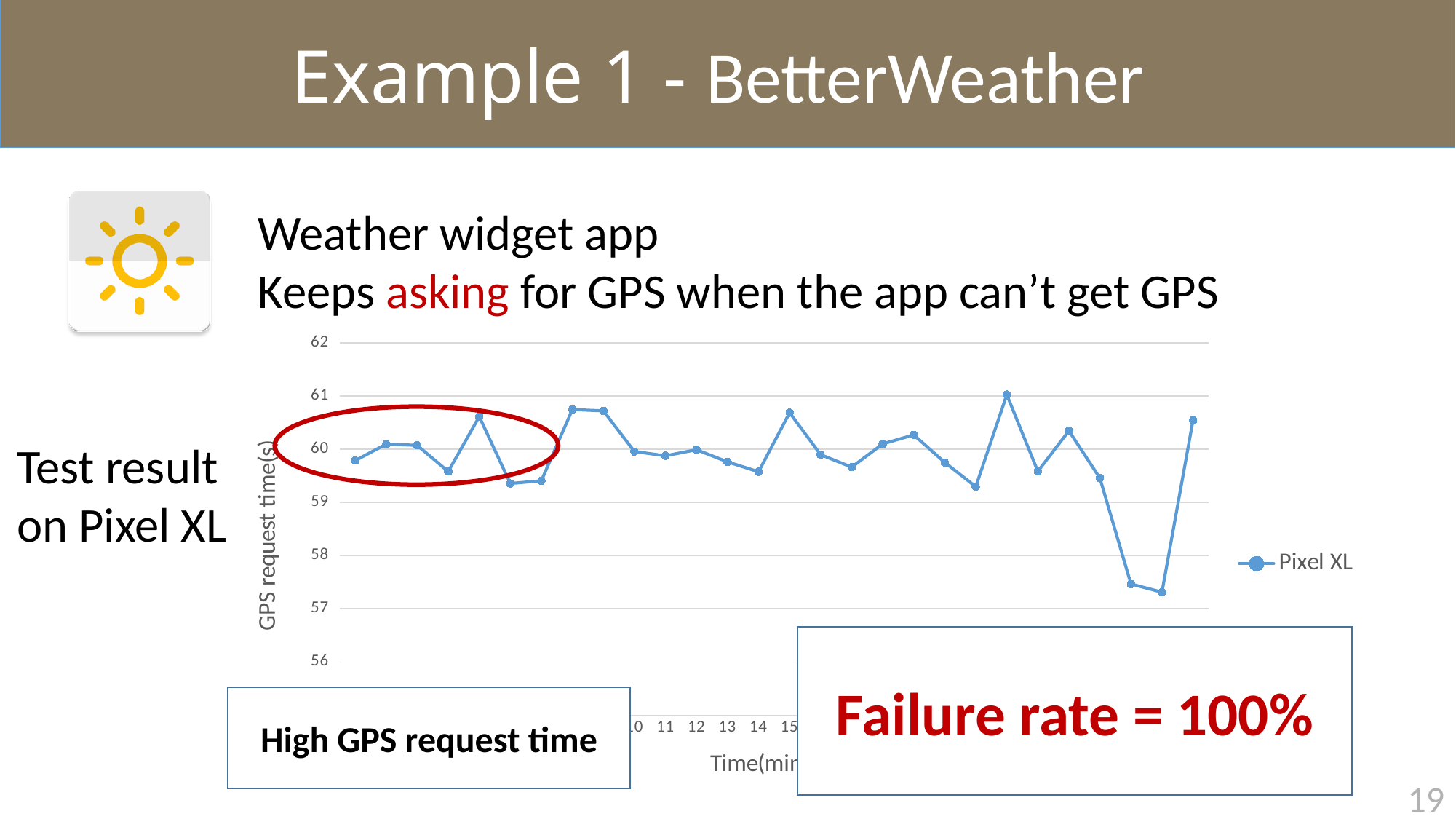
What is the name of the series shown in the chart legend? Pixel XL How many data points are plotted for the Pixel XL series? 28 What is the title of the vertical axis of the chart? GPS request time(s) What is the highest value shown on the vertical axis of the chart? 62 Is the Pixel XL value at minute 12 greater or less than 59? greater What kind of chart is shown on the slide? line chart At which minute does the Pixel XL series reach its highest GPS request time? 22 Is the Pixel XL value at minute 22 greater or less than 60? greater Is the Pixel XL value at minute 26 greater or less than 58? less Which is larger, the Pixel XL value at minute 12 or at minute 26? minute 12 How many series does the chart legend list? 1